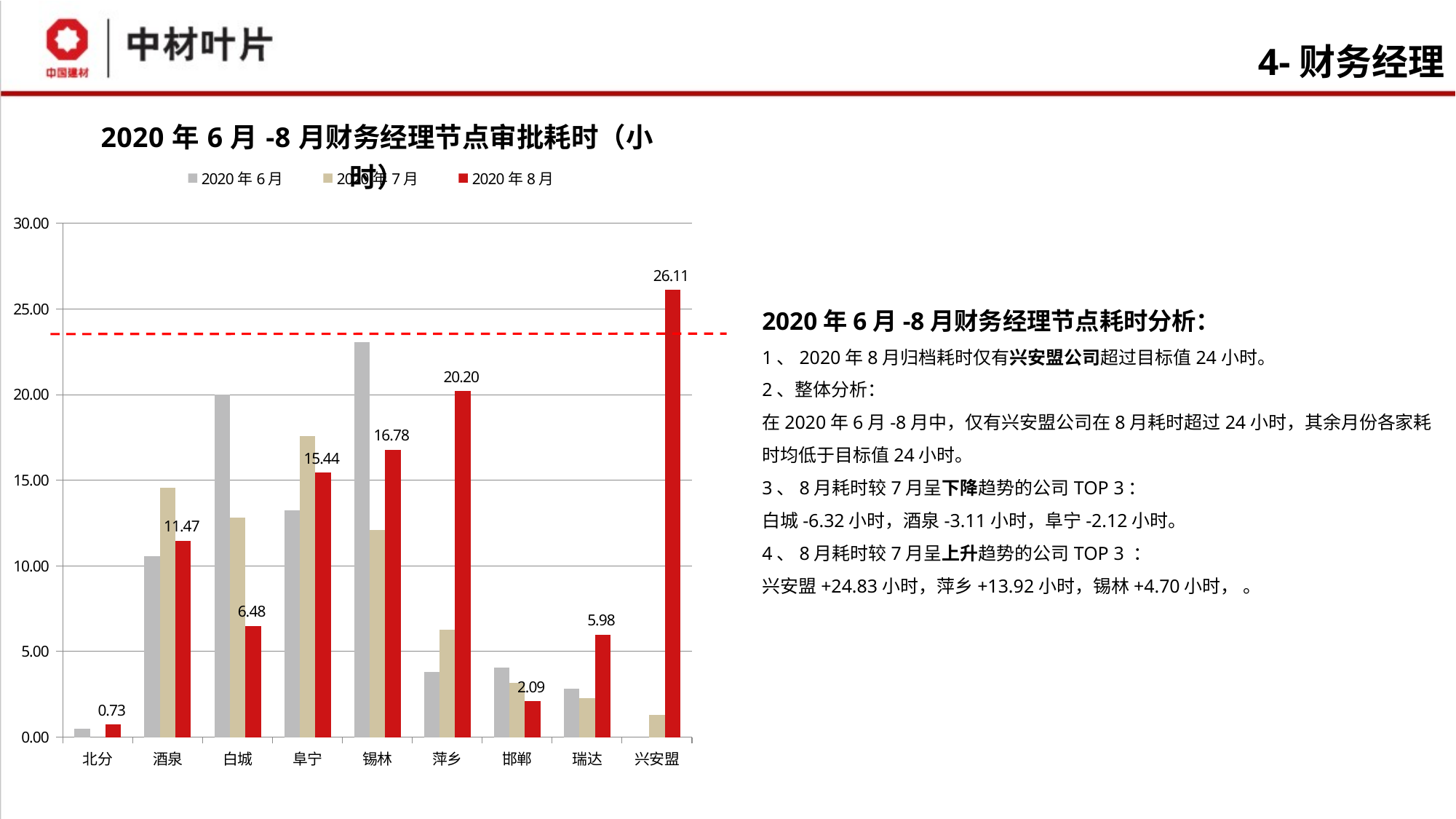
Which category has the lowest 2020年8月 value? 北分 What is the 2020年8月 value for 邯郸? 2.09 What is the 2020年8月 value for 兴安盟? 26.11 What kind of chart is shown on the slide? bar chart What is the 2020年8月 value for 北分? 0.73 Is the 2020年6月 value for 锡林 greater or less than 20.00? greater How many categories are shown on the x axis? 9 What is the difference between the 2020年8月 values for 锡林 and 阜宁? 1.34 What is the 2020年8月 value for 萍乡? 20.20 How many series does the legend list? 3 Which has the larger 2020年8月 value, 酒泉 or 白城? 酒泉 Which category has the highest 2020年8月 value? 兴安盟